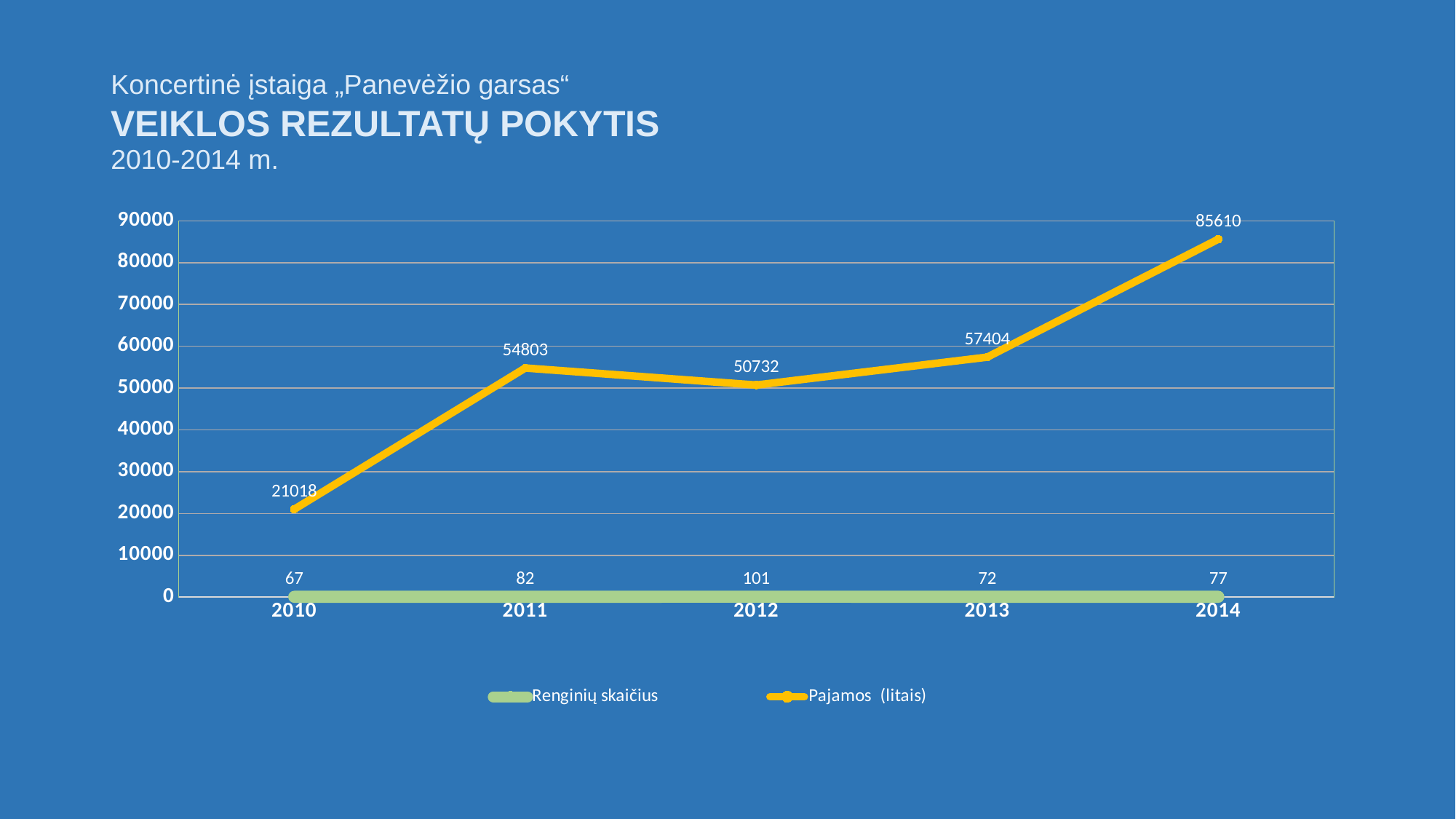
What is the difference between Pajamos (litais) in 2014 and in 2013? 28206 Does Pajamos (litais) rise or fall from 2013 to 2014? rise What is the value of Renginių skaičius in 2012? 101 What is the value of Pajamos (litais) in 2010? 21018 In which year is Renginių skaičius lowest? 2010 In which year is Pajamos (litais) highest? 2014 How many years are shown on the x axis? 5 Which year has the larger Pajamos (litais) value, 2011 or 2012? 2011 What is the value of Pajamos (litais) in 2014? 85610 What kind of chart is shown on the slide? line chart Is the value of Pajamos (litais) in 2013 greater or less than 50000? greater How many series does the legend list? 2